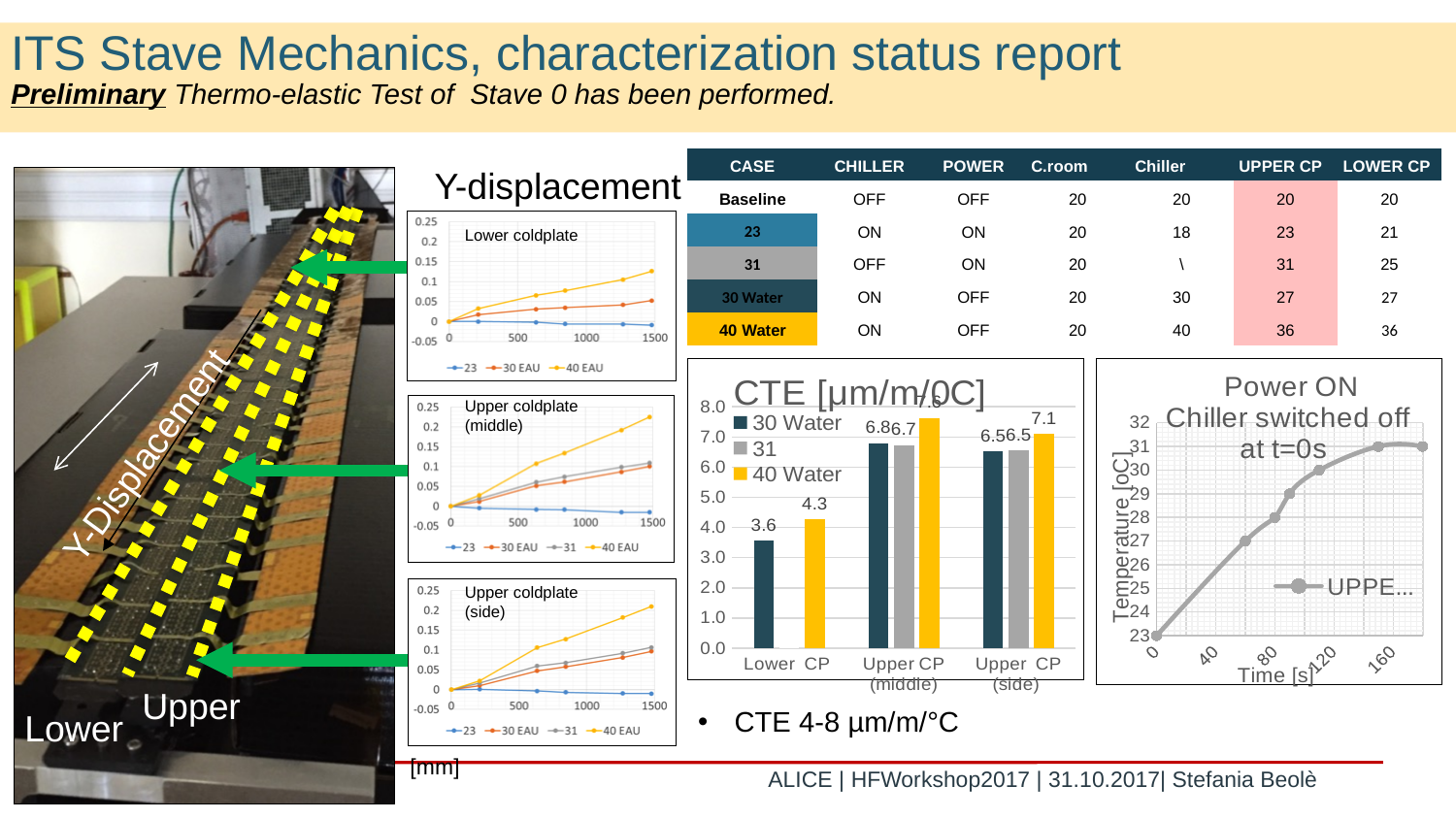
In the CTE [µm/m/°C] bar chart, what is the 40 Water value for Lower CP? 4.3 In the 'Power ON Chiller switched off at t=0s' chart, does the temperature rise or fall as time increases? rise How many categories are shown on the x axis of the CTE [µm/m/°C] chart? 3 In the CTE [µm/m/°C] bar chart, which category has the highest 40 Water value? Upper CP (middle) In the CTE [µm/m/°C] bar chart, what is the 31 value for Upper CP (middle)? 6.7 How many series does the legend of the CTE [µm/m/°C] chart list? 3 In the CTE [µm/m/°C] bar chart, which is larger for Lower CP: the 30 Water value or the 40 Water value? 40 Water How many series does the legend of the 'Lower coldplate' Y-displacement chart list? 3 In the CTE [µm/m/°C] bar chart, what is the difference between the 40 Water and 30 Water values for Lower CP? 0.7 What kind of chart is the CTE [µm/m/°C] chart? bar chart In the CTE [µm/m/°C] bar chart, what is the 40 Water value for Upper CP (side)? 7.1 In the CTE [µm/m/°C] bar chart, what is the 30 Water value for Lower CP? 3.6